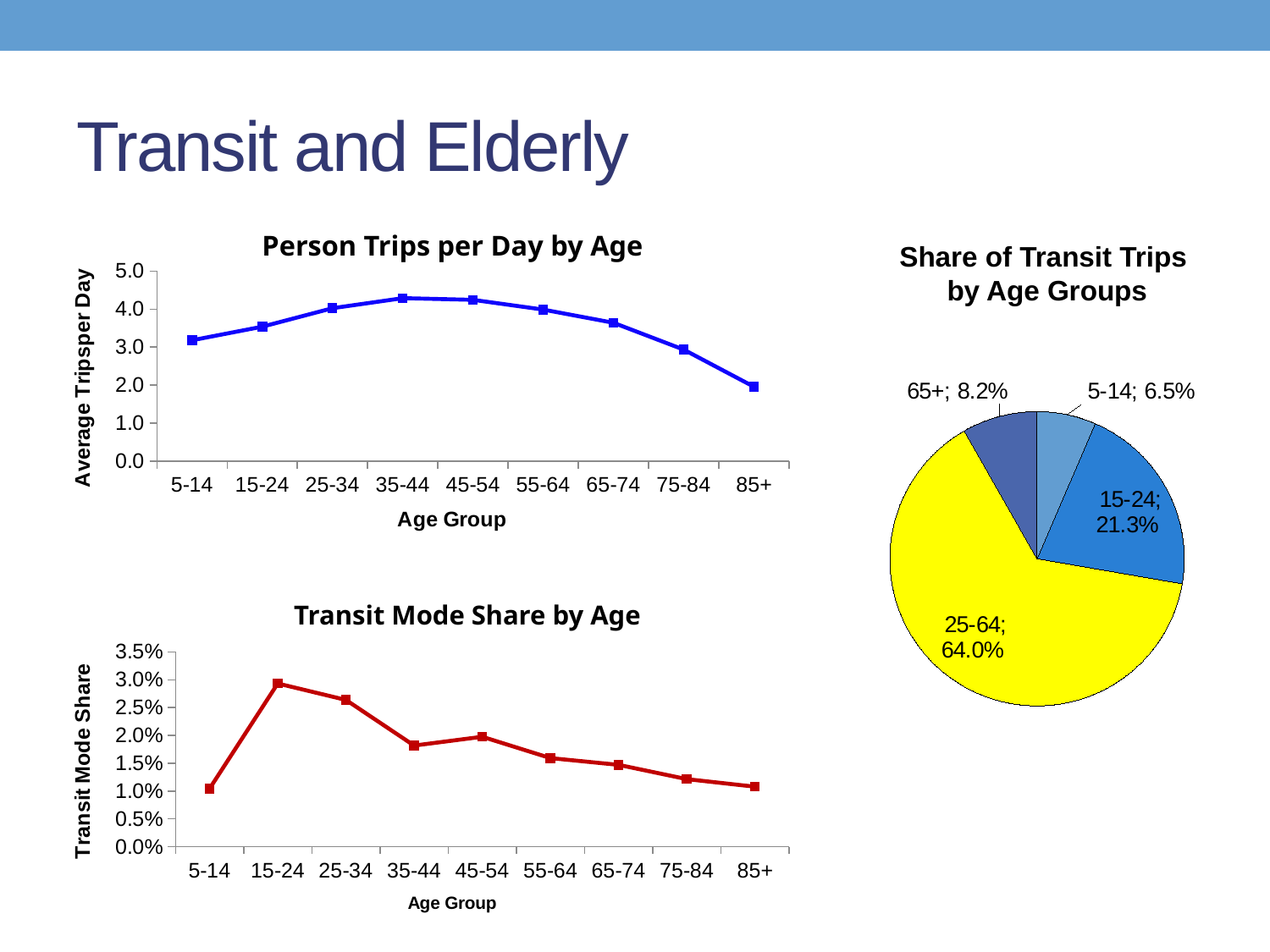
In the 'Share of Transit Trips by Age Groups' pie chart, what is the difference between the 15-24 share and the 5-14 share? 14.8% In the 'Person Trips per Day by Age' chart, which age group has the lowest average trips per day? 85+ What kind of chart is 'Person Trips per Day by Age'? Line chart How many age groups are plotted in the 'Transit Mode Share by Age' chart? 9 How many slices does the 'Share of Transit Trips by Age Groups' pie chart have? 4 In the 'Share of Transit Trips by Age Groups' pie chart, what share do the 25-64 age group have? 64.0% In the 'Person Trips per Day by Age' chart, is the value for 35-44 greater or less than 4.0? greater In the 'Share of Transit Trips by Age Groups' pie chart, which age group has the smallest share? 5-14 In the 'Share of Transit Trips by Age Groups' pie chart, what is the share for the 65+ age group? 8.2% In the 'Transit Mode Share by Age' chart, which is larger, the value for 25-34 or the value for 45-54? 25-34 In the 'Transit Mode Share by Age' chart, is the value for 35-44 greater or less than 2.0%? less In the 'Transit Mode Share by Age' chart, which age group has the highest transit mode share? 15-24